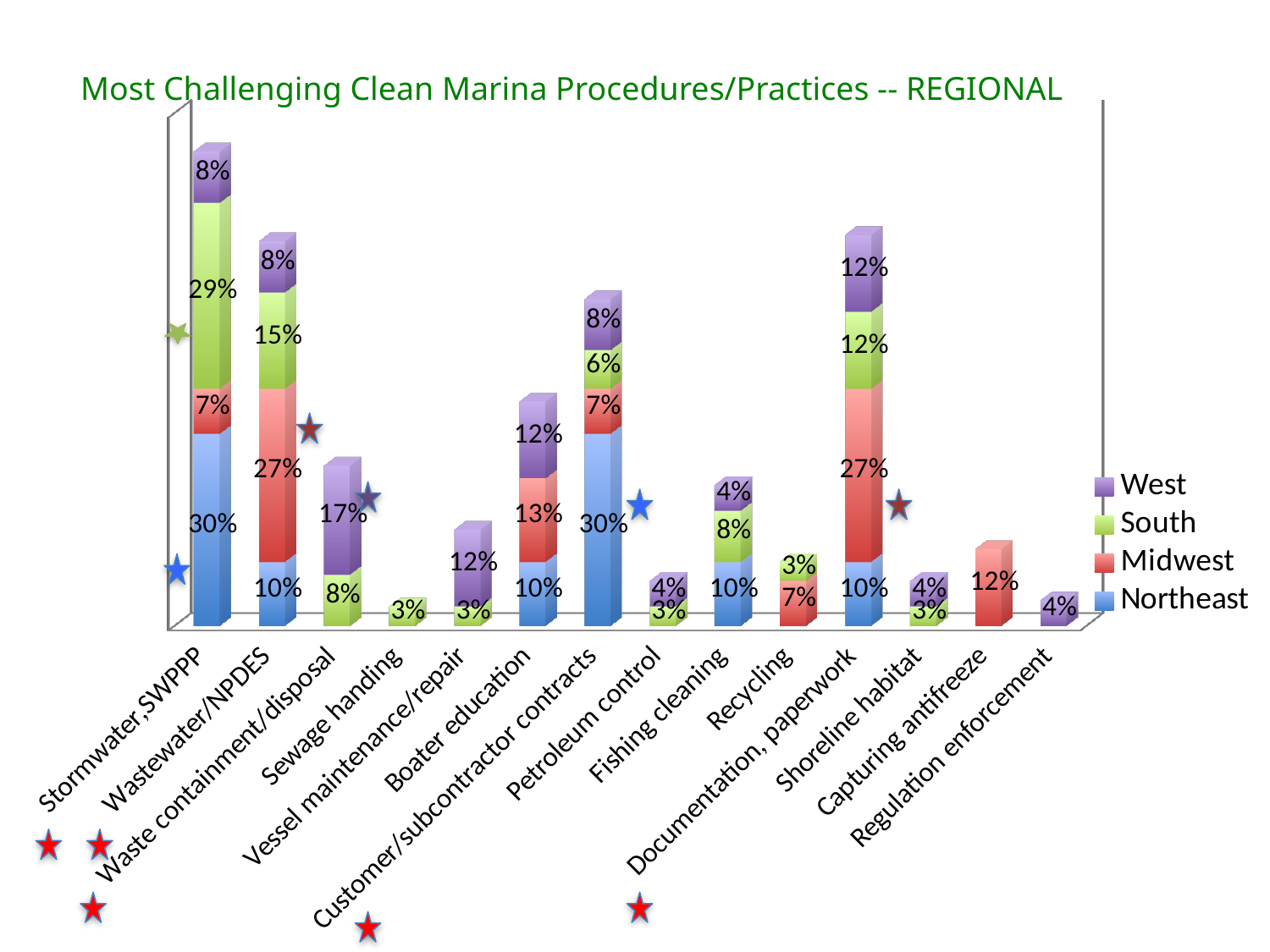
How many series does the legend list? 4 What is the Midwest value for Wastewater/NPDES? 27% How many categories are shown along the x axis? 14 What is the South value for Documentation, paperwork? 12% Which series is shown in purple in the legend? West Which is larger, the Midwest value for Boater education or the Midwest value for Capturing antifreeze? Boater education What is the West value for Waste containment/disposal? 17% What is the Northeast value for Stormwater,SWPPP? 30% What is the total of the stacked bar for Boater education? 35% What is the total of the stacked bar for Stormwater,SWPPP? 74% What kind of chart is shown on the slide? Stacked bar chart What is the difference between the South value for Stormwater,SWPPP and the South value for Wastewater/NPDES? 14%